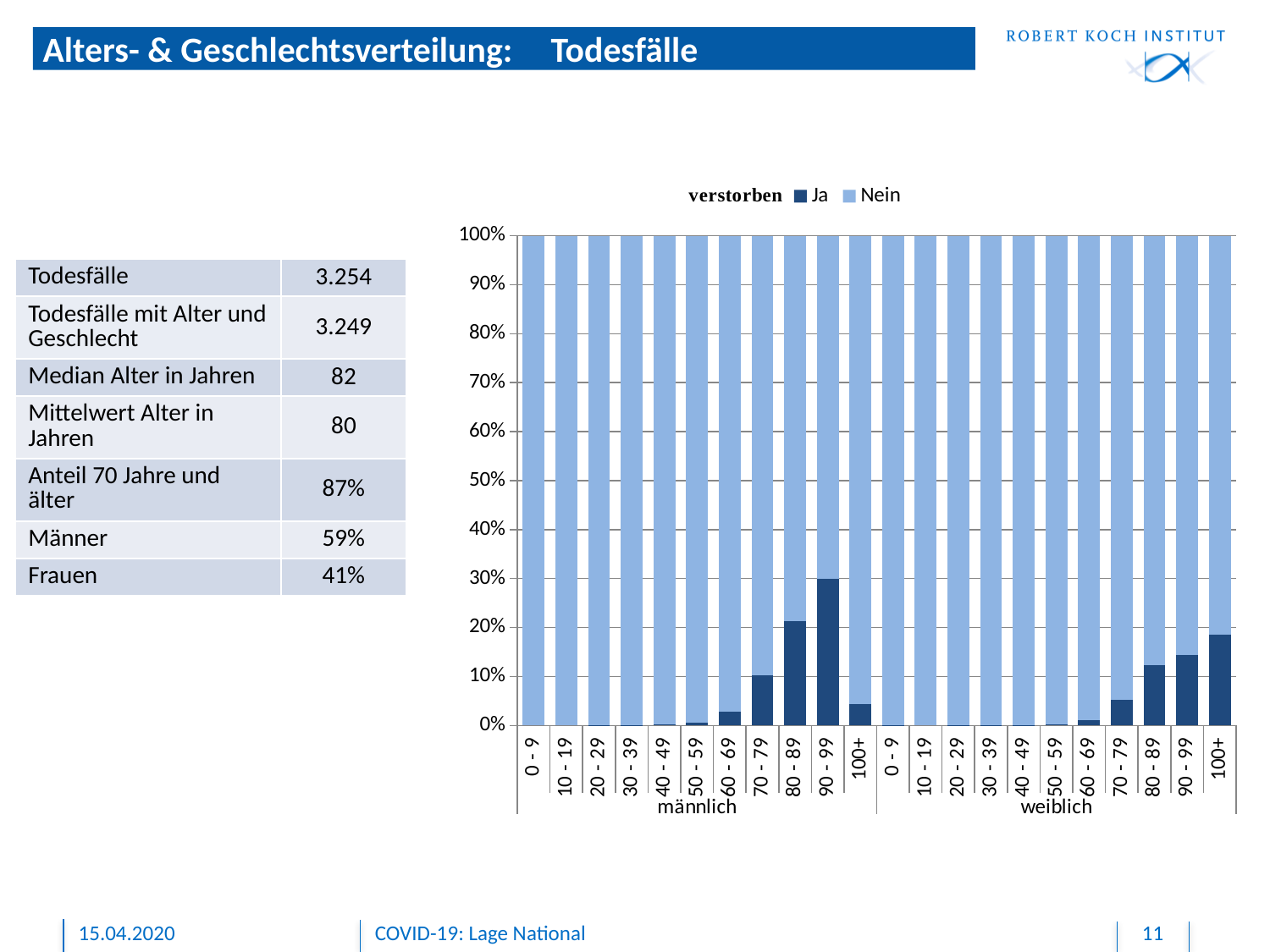
How many age-group bars are plotted in the chart in total? 22 What kind of chart is shown on the slide? stacked bar chart Among the männlich age groups, which has the highest share of 'Ja' (verstorben)? 90 - 99 What is the title shown next to the chart legend? verstorben How many age groups are shown for the männlich group in the chart? 11 Is the 'Ja' share for männlich 90 - 99 greater or less than 20%? greater Is the 'Ja' share for weiblich 90 - 99 greater or less than 20%? less Among the weiblich age groups, which has the highest share of 'Ja' (verstorben)? 100+ How many series does the chart legend list? 2 What are the two series named in the chart legend? Ja and Nein Which is larger, the 'Ja' share for männlich 90 - 99 or for weiblich 90 - 99? männlich 90 - 99 Within the männlich group, does the 'Ja' share generally rise or fall from age group 50 - 59 to 90 - 99? rise